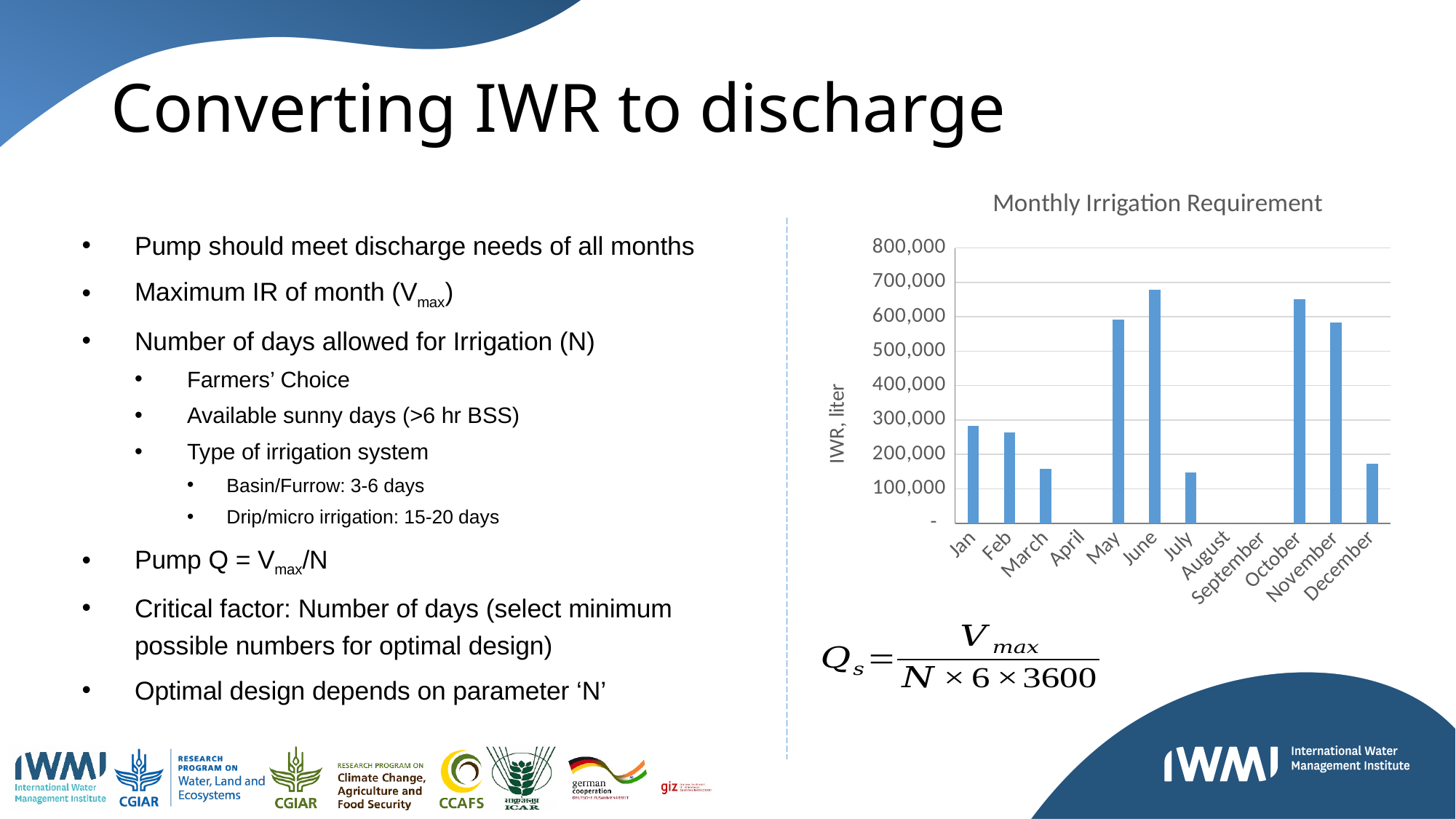
Which month has the highest irrigation requirement in the chart? June Is the value for Jan greater or less than 300,000? less Is the value for June greater or less than 600,000? greater How many months are listed along the x axis of the chart? 12 What kind of chart is shown on the slide? Bar chart Is the value for March greater or less than 200,000? less What is the title of the chart? Monthly Irrigation Requirement What is the label on the vertical axis of the chart? IWR, liter Which has a larger irrigation requirement, June or July? June Which has a larger irrigation requirement, Jan or March? Jan Do the values rise or fall from Jan to March? fall